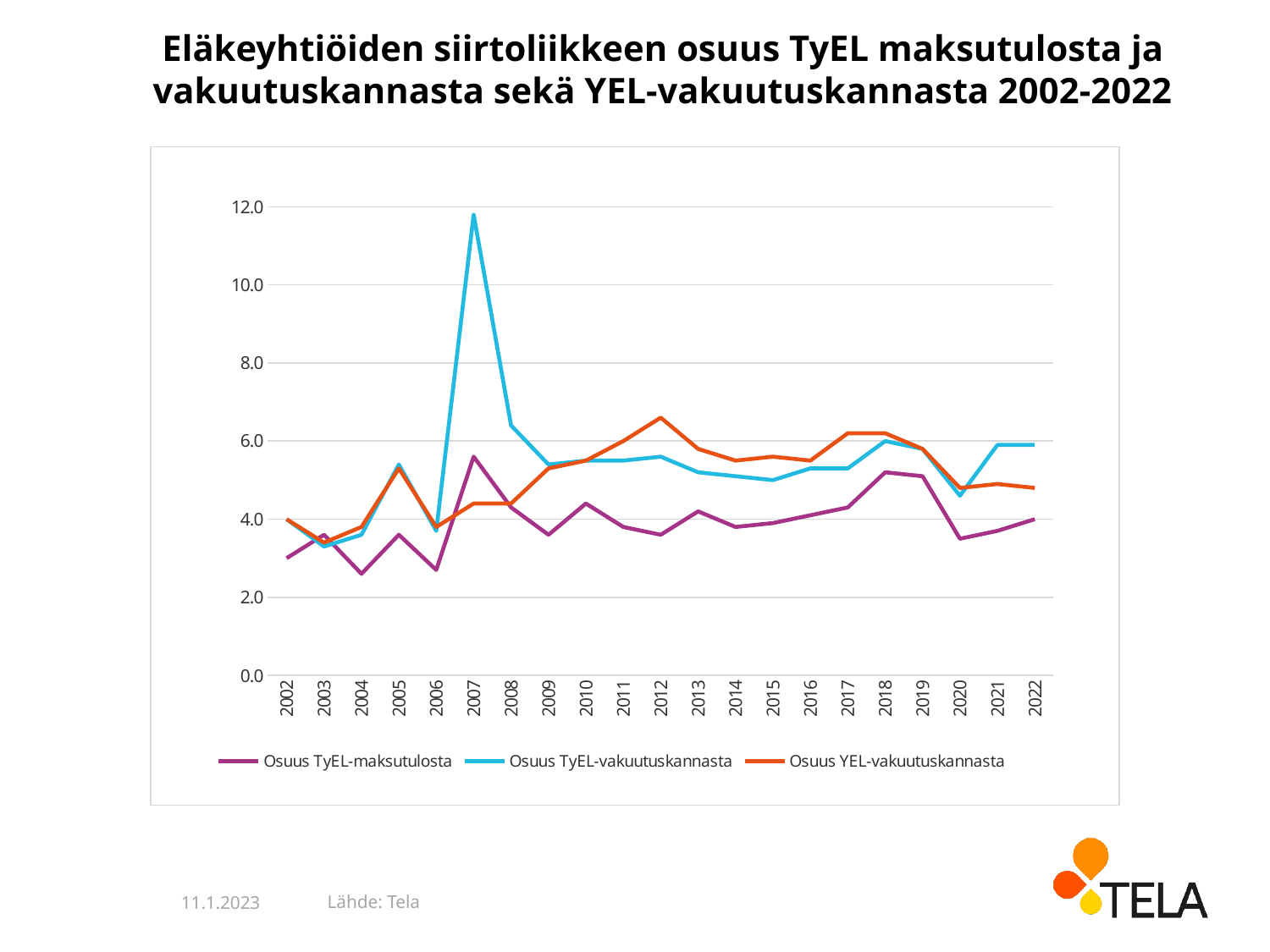
Is the value for Osuus TyEL-maksutulosta in 2004 greater or less than 4.0? less Is the value for Osuus TyEL-vakuutuskannasta in 2007 greater or less than 10.0? greater In 2007, which series has the larger value: Osuus TyEL-vakuutuskannasta or Osuus TyEL-maksutulosta? Osuus TyEL-vakuutuskannasta What kind of chart is shown on the slide? line chart How many years are plotted along the x axis? 21 In which year does the Osuus YEL-vakuutuskannasta series reach its highest value? 2012 Does the Osuus TyEL-vakuutuskannasta series rise or fall from 2007 to 2009? fall How many series does the legend list? 3 In which year does the Osuus TyEL-vakuutuskannasta series reach its highest value? 2007 Is the value for Osuus YEL-vakuutuskannasta in 2012 greater or less than 6.0? greater What is the source given at the bottom of the slide? Tela In which year does the Osuus TyEL-maksutulosta series reach its highest value? 2007